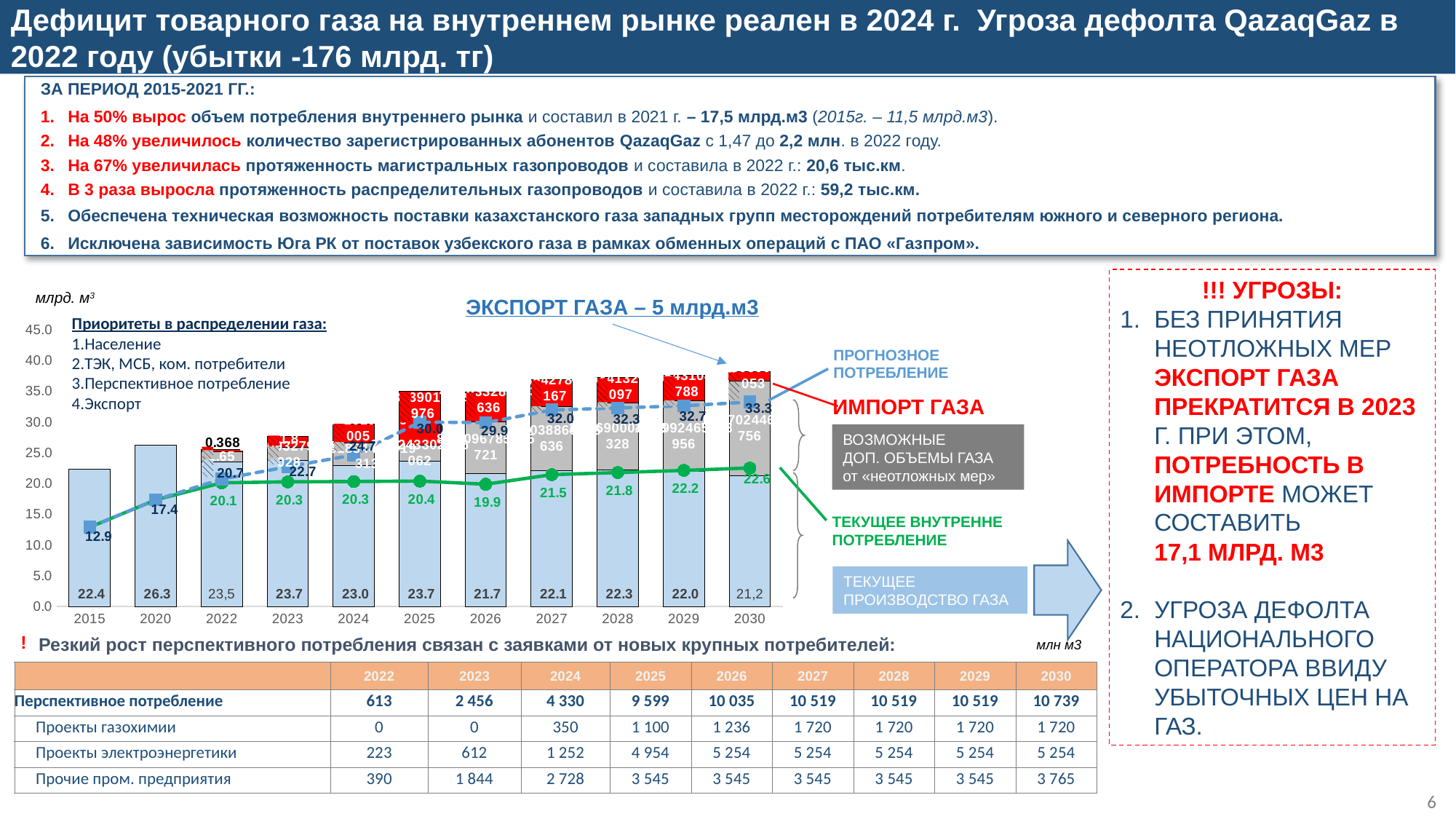
What is the current gas production (bar value) for 2020? 26.3 Which is larger: the forecast consumption for 2025 or for 2030? 2030 What kind of chart is shown on the slide? A bar chart combined with line series What is the current gas production (bar value) for 2015? 22.4 What is the forecast consumption (прогнозное потребление) value for 2030? 33.3 What is the current domestic consumption (текущее внутреннее потребление) value for 2030? 22.6 How many years are shown on the x axis of the chart? 11 Is the gas production bar for 2030 greater or less than 25.0? less What is the difference between the gas production bars for 2020 and 2015? 3.9 Which year has the highest current gas production bar? 2020 Does the forecast consumption line rise or fall from 2022 to 2030? rises What is the current domestic consumption value for 2026? 19.9